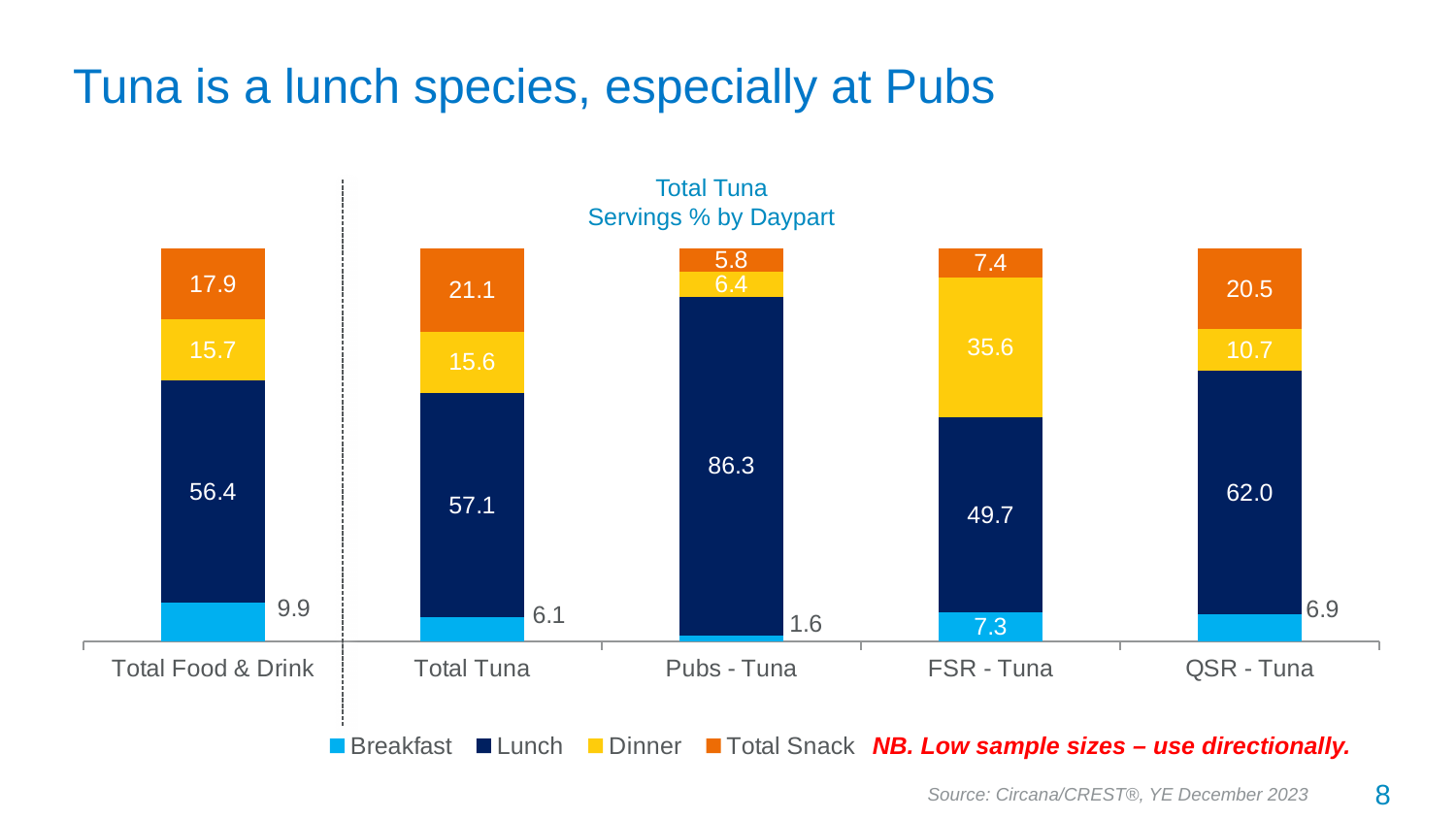
How many series does the legend list? 4 What is the Lunch value for Pubs - Tuna? 86.3 What is the Breakfast value for Total Food & Drink? 9.9 What is the Total Snack value for QSR - Tuna? 20.5 What is the Dinner value for FSR - Tuna? 35.6 What is the total of the stacked bar for FSR - Tuna? 100.0 What is the difference between the Lunch values for Pubs - Tuna and FSR - Tuna? 36.6 Which is larger, the Total Snack value for Total Tuna or for QSR - Tuna? Total Tuna How many categories are shown on the x axis? 5 Which category has the lowest Breakfast value? Pubs - Tuna Which category has the highest Lunch value? Pubs - Tuna What kind of chart is shown on the slide? Stacked bar chart